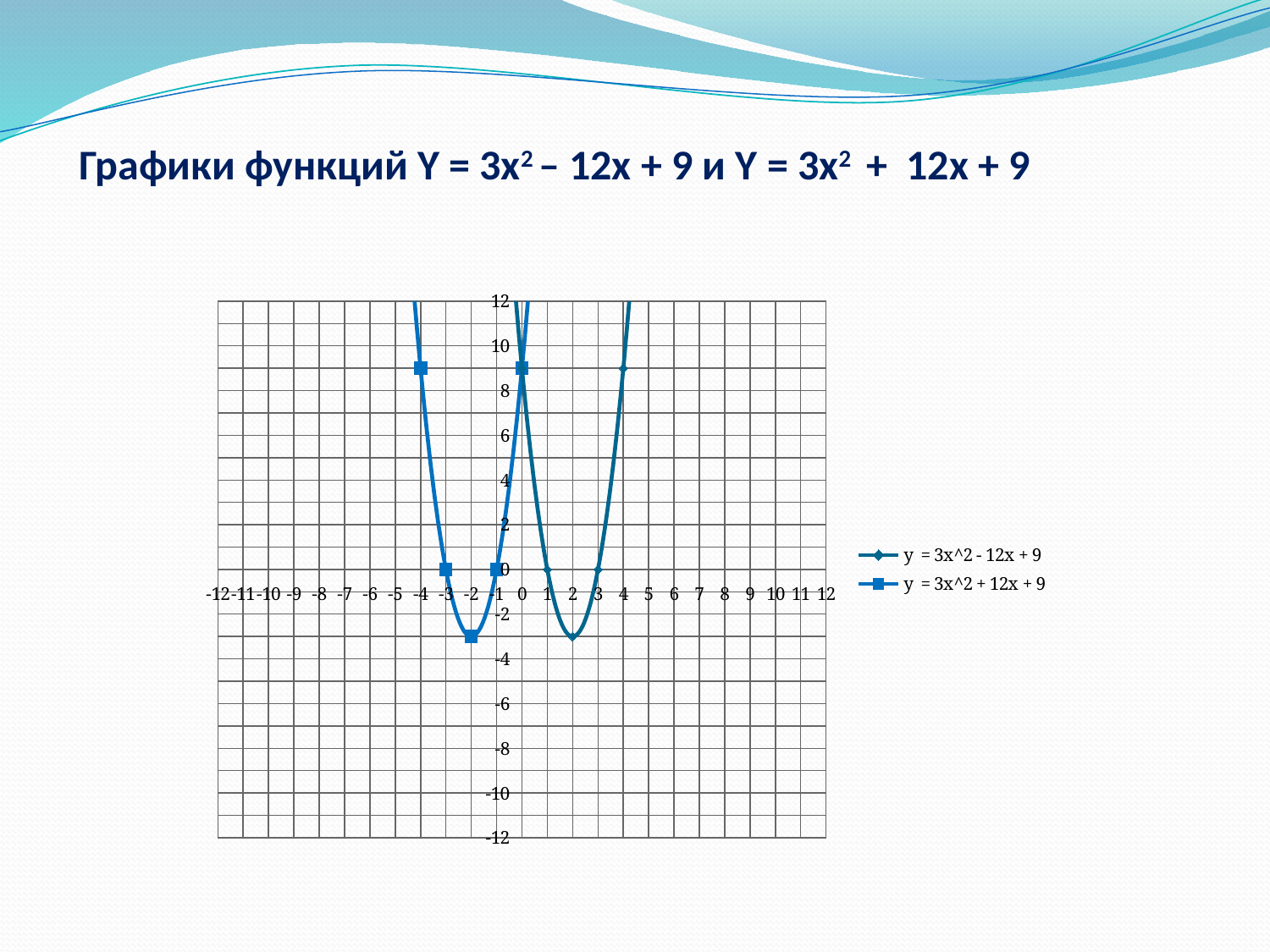
Is the value of y = 3x^2 - 12x + 9 at x = 0 greater or less than 8? greater What is the value of y = 3x^2 - 12x + 9 at x = 1? 0 What is the value of y = 3x^2 + 12x + 9 at x = -1? 0 Do the values of y = 3x^2 - 12x + 9 rise or fall as x goes from 0 to 2? fall Is the value of y = 3x^2 - 12x + 9 at x = 2 greater or less than 0? less What is the value of y = 3x^2 - 12x + 9 at x = 3? 0 What is the value of y = 3x^2 + 12x + 9 at x = -3? 0 How many series does the legend list? 2 What kind of chart is shown on the slide? line chart What are the two series named in the legend? y = 3x^2 - 12x + 9 and y = 3x^2 + 12x + 9 What is the highest value shown on the vertical axis? 12 Is the value of y = 3x^2 + 12x + 9 at x = -2 greater or less than 0? less